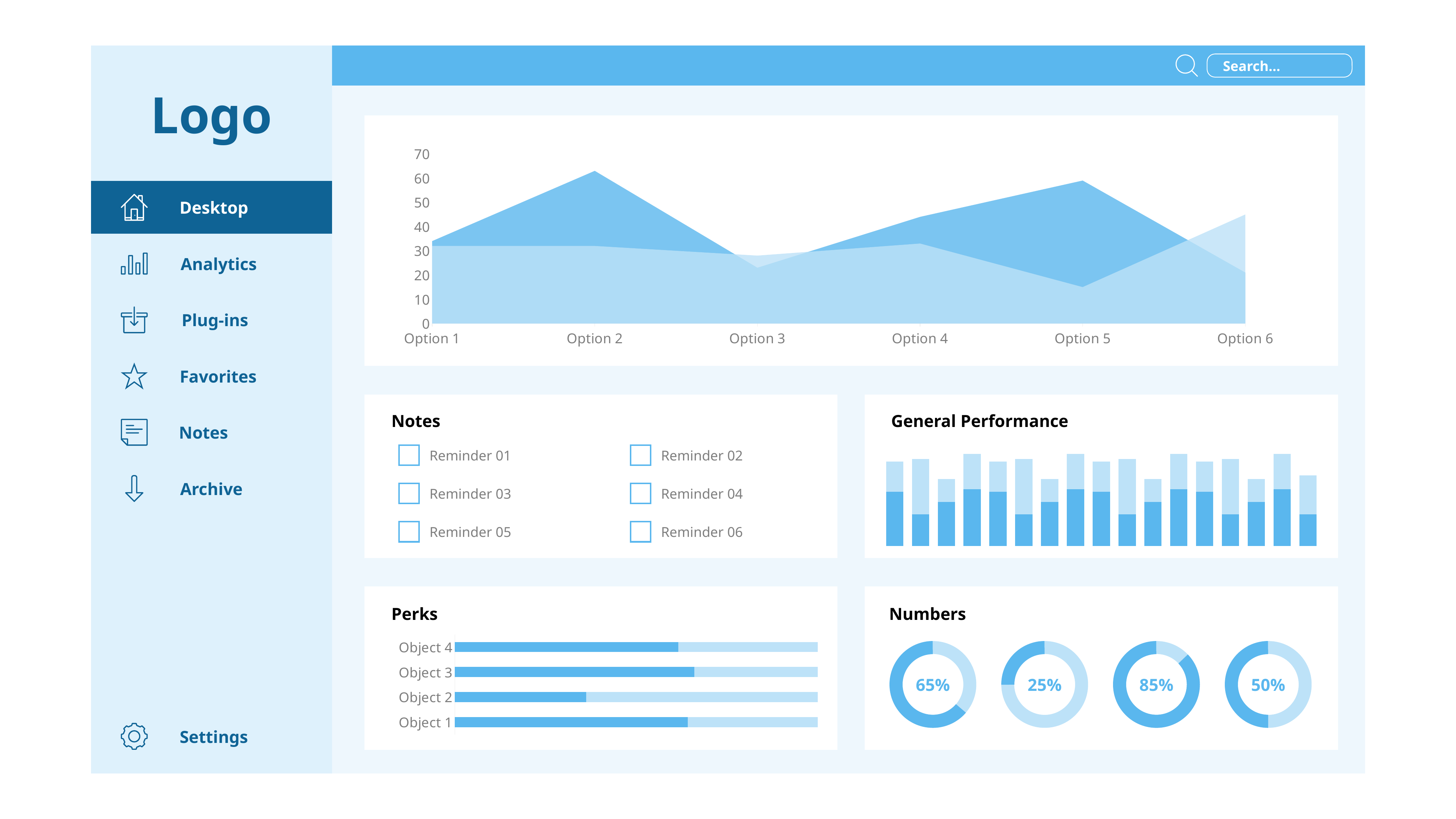
In the Perks chart, which has the longer dark blue bar, Object 2 or Object 3? Object 3 In the Numbers panel, how many donut charts are shown? 4 In the top area chart, is the lowest value at Option 5 greater or less than 20? less What kind of chart is the large chart at the top of the slide with Option 1 to Option 6 on the x axis? area chart What is the highest value shown on the y axis of the top area chart? 70 In the Numbers panel, what percentage does the first (leftmost) donut chart show? 65% In the Numbers panel, what is the difference between the highest and lowest percentages shown? 60% In the Numbers panel, which donut chart shows the lowest percentage? 25% What kind of chart is shown in the Perks panel? bar chart In the Numbers panel, what percentage does the third donut chart show? 85% How many categories are shown on the x axis of the top area chart? 6 In the top area chart, is the peak value at Option 2 greater or less than 50? greater